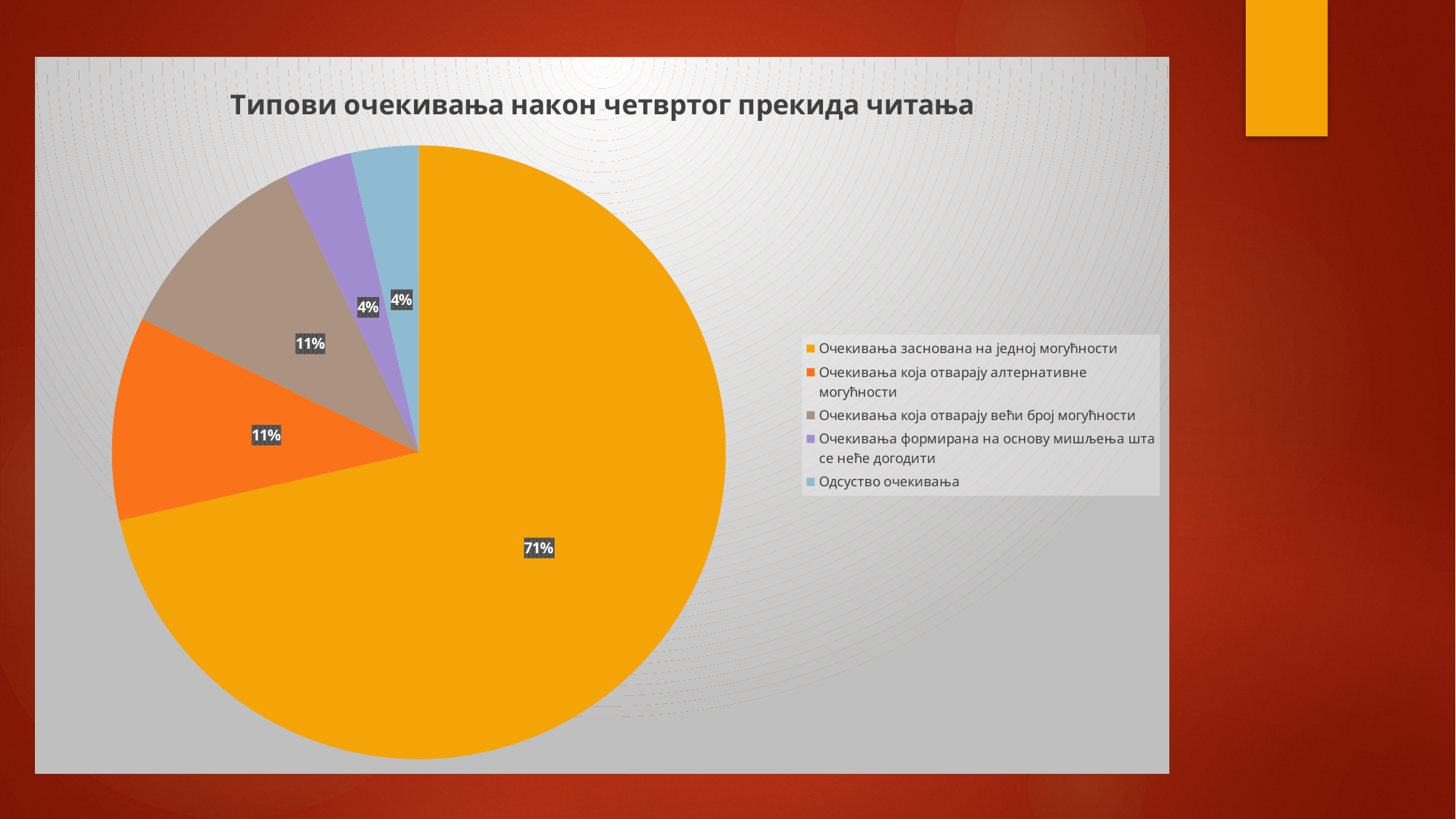
Which category has the largest slice of the pie? Очекивања заснована на једној могућности What percentage is shown for 'Очекивања формирана на основу мишљења шта се неће догодити'? 4% What is the title of the chart? Типови очекивања након четвртог прекида читања How many entries does the legend list? 5 What is the difference in percentage points between the 'Очекивања заснована на једној могућности' slice and the 'Очекивања која отварају алтернативне могућности' slice? 60 percentage points What type of chart is shown on the slide? pie chart How many slices does the pie chart have? 5 What share of the pie is labelled for 'Очекивања заснована на једној могућности'? 71% What percentage is shown for 'Одсуство очекивања'? 4% What percentage is shown for 'Очекивања која отварају алтернативне могућности'? 11% Which is larger: the slice for 'Очекивања заснована на једној могућности' or the slice for 'Очекивања која отварају већи број могућности'? Очекивања заснована на једној могућности What percentage is shown for 'Очекивања која отварају већи број могућности'? 11%